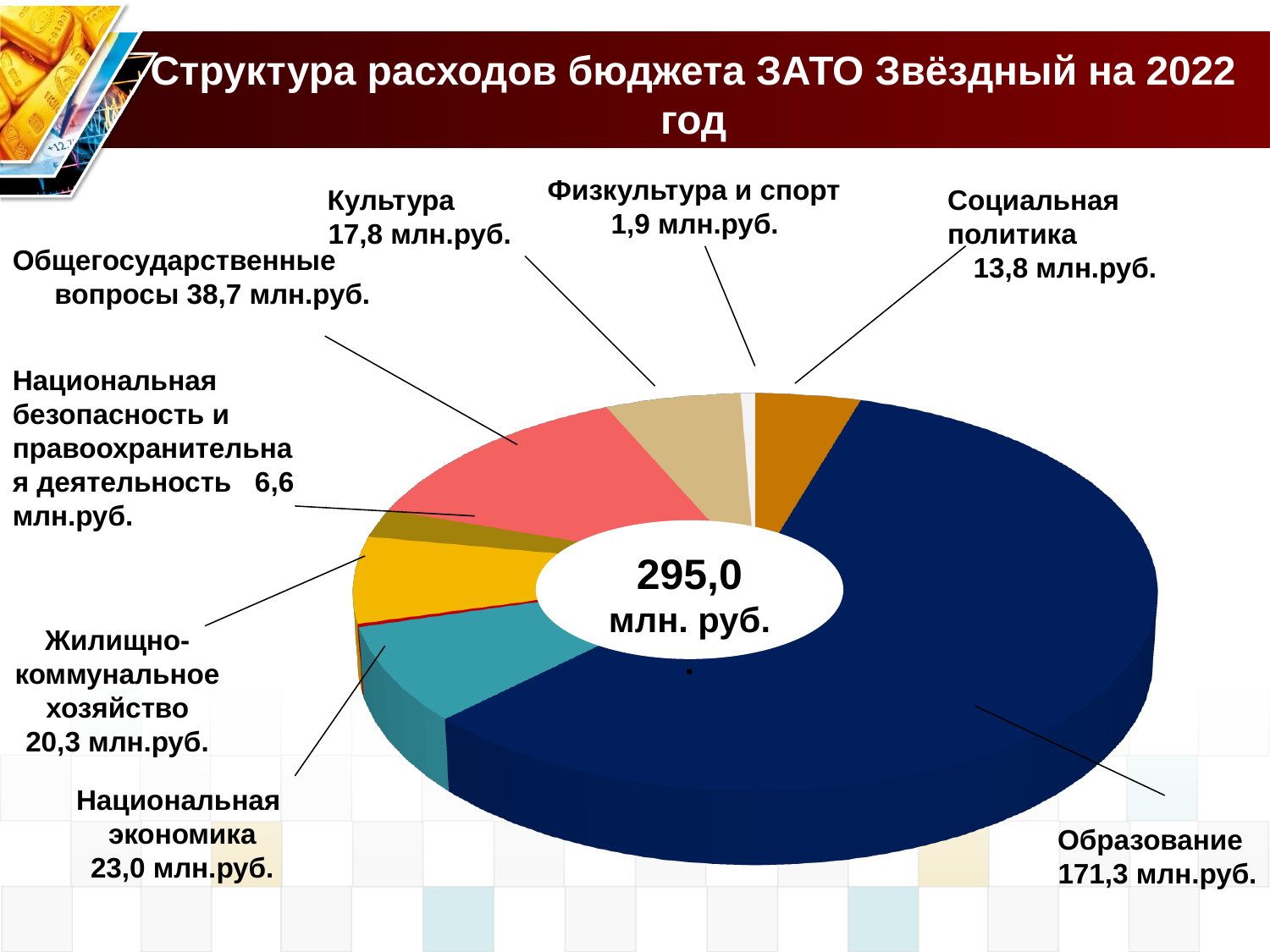
Which category has the largest share of the budget expenditure? Образование What total value is printed in the centre of the pie chart? 295,0 млн. руб. What is the difference between Национальная экономика and Жилищно-коммунальное хозяйство? 2,7 млн.руб. What is the title of the chart on the slide? Структура расходов бюджета ЗАТО Звёздный на 2022 год What is the value for Жилищно-коммунальное хозяйство? 20,3 млн.руб. What is the value for Общегосударственные вопросы? 38,7 млн.руб. What kind of chart is shown on the slide? pie chart Which is larger, Культура or Социальная политика? Культура Which labelled category has the smallest value? Физкультура и спорт What is the value for Образование? 171,3 млн.руб. What is the value for Физкультура и спорт? 1,9 млн.руб. What colour is the Образование slice? dark blue